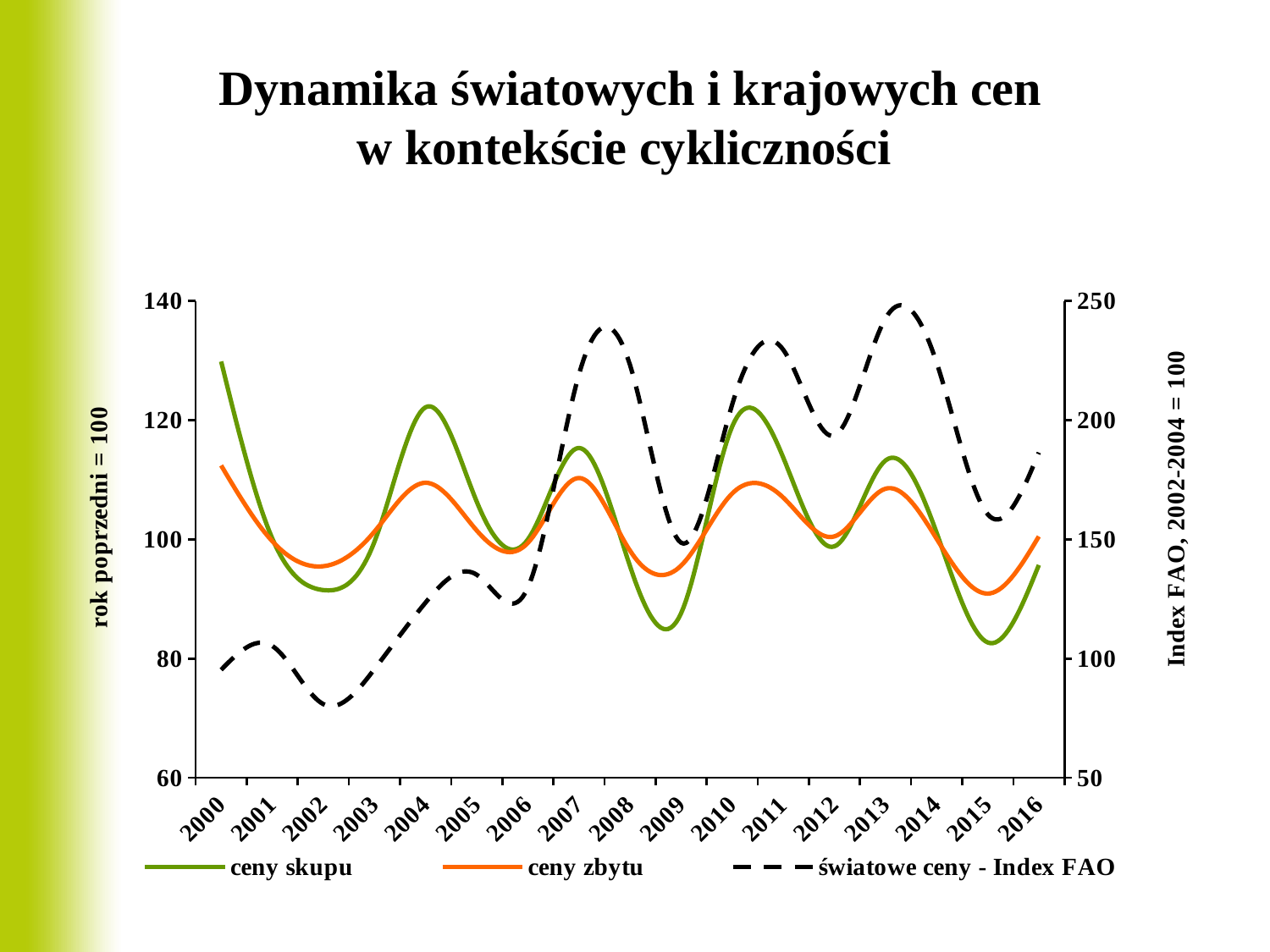
Is the value for ceny skupu in 2009 greater or less than 100? less What kind of chart is shown on the slide? line chart In 2000, which is larger: ceny skupu or ceny zbytu? ceny skupu Is the value for światowe ceny - Index FAO in 2002 greater or less than 100 on the right axis? less How many years are shown on the x axis? 17 Which series is drawn with a dashed black line? światowe ceny - Index FAO Is the value for światowe ceny - Index FAO in 2013 greater or less than 200 on the right axis? greater What is the title of the chart? Dynamika światowych i krajowych cen w kontekście cykliczności In which year does ceny skupu reach its highest value? 2000 How many series does the legend list? 3